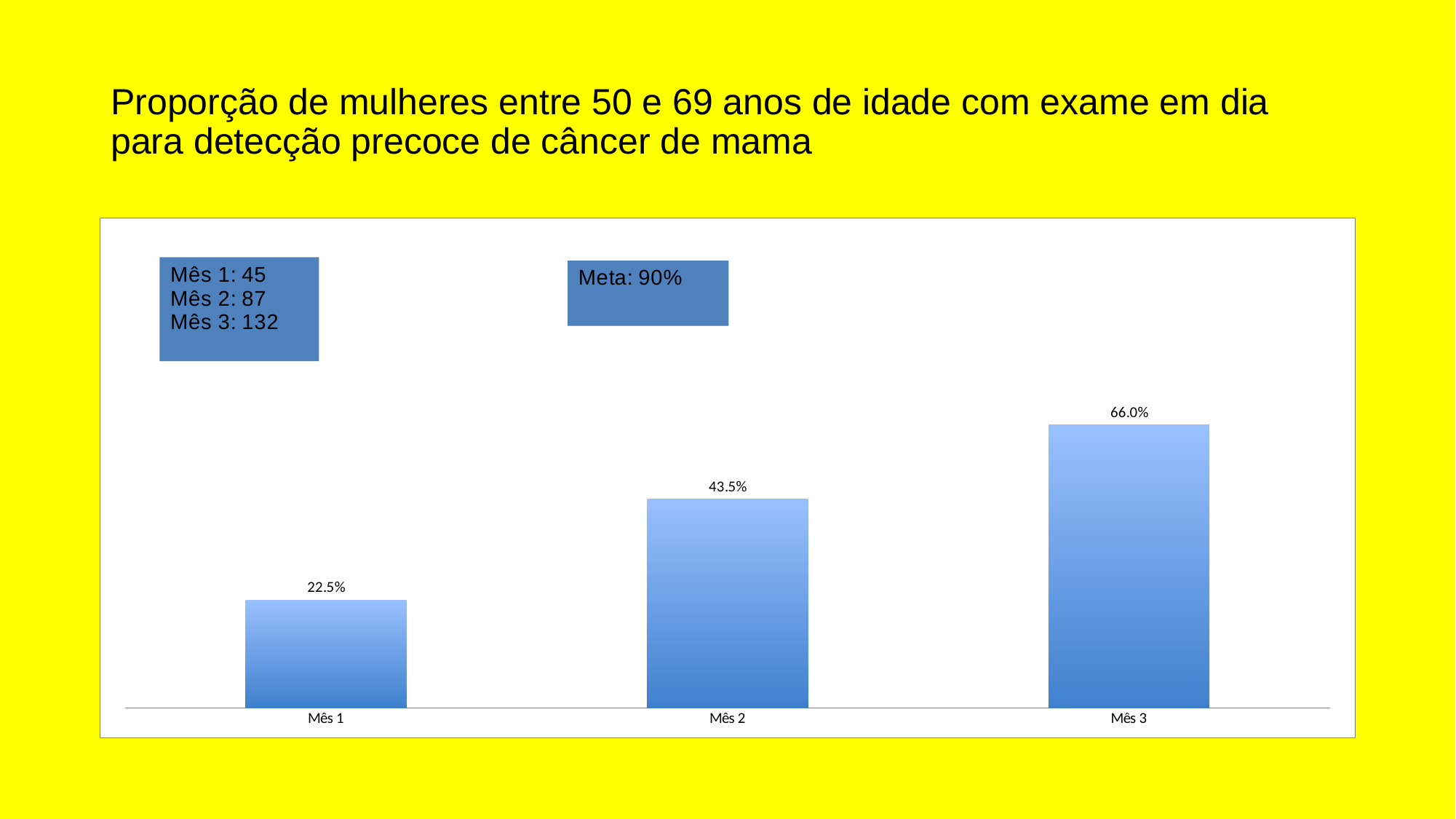
What is the value for Mês 2? 43.5% What is the difference between the values for Mês 3 and Mês 1? 43.5% Which month has the lowest value? Mês 1 How many categories are shown on the x axis? 3 What is the difference between the values for Mês 2 and Mês 1? 21.0% What kind of chart is shown on the slide? Bar chart Which is larger, the value for Mês 2 or the value for Mês 3? Mês 3 What is the value for Mês 3? 66.0% Which month has the highest value? Mês 3 Do the values rise or fall from Mês 1 to Mês 3? Rise What is the value for Mês 1? 22.5% What target (Meta) is stated in the text box on the chart? 90%